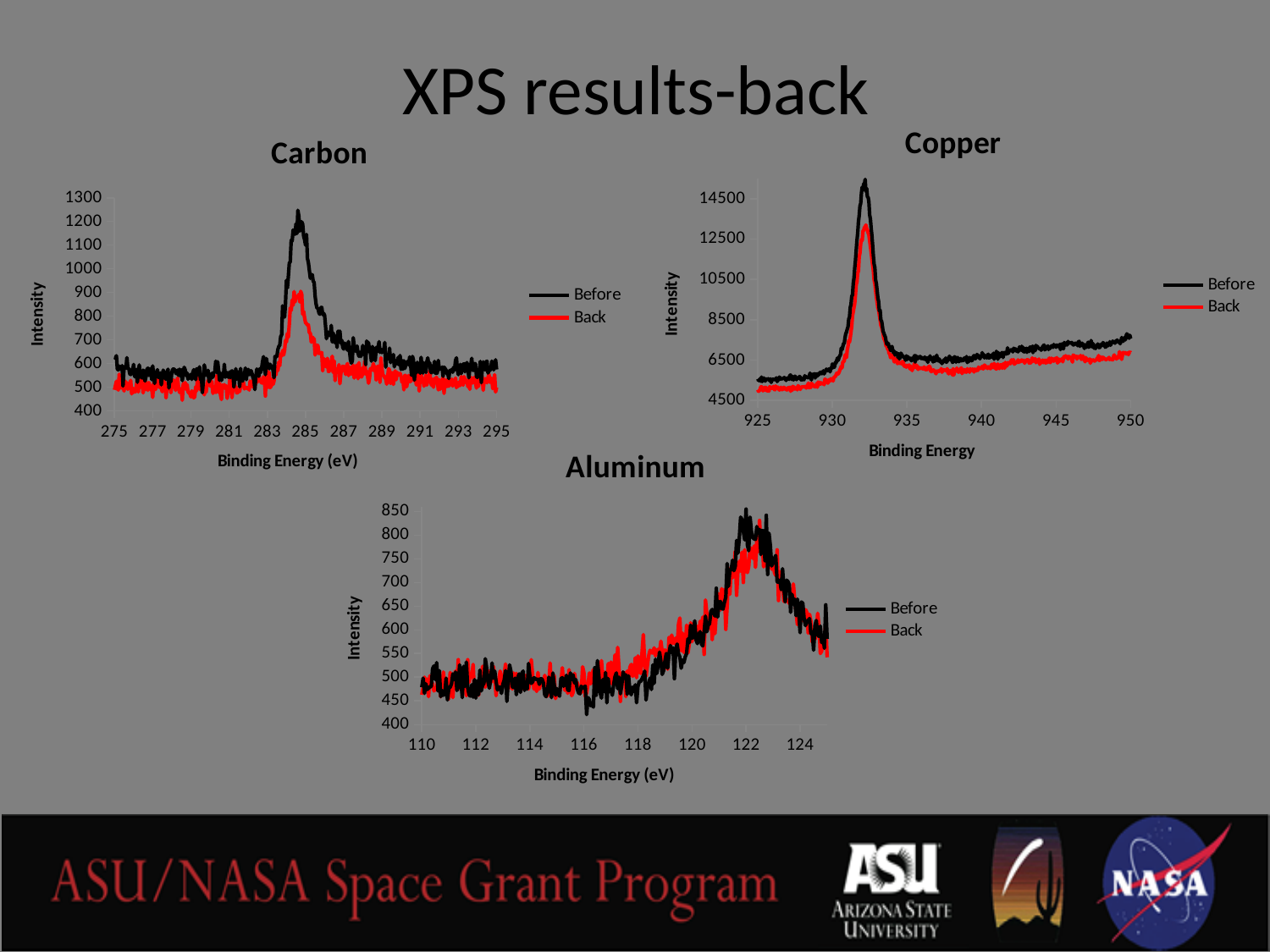
What are the two legend entries in the Aluminum chart? Before and Back In the Carbon chart, which series reaches the higher peak intensity, Before or Back? Before In the Aluminum chart, is the intensity of the Back series at 110 eV greater or less than 550? less How many series does the legend of the Copper chart list? 2 In the Copper chart, which series has the lower peak intensity, Before or Back? Back In the Carbon chart, is the peak intensity of the Before series greater or less than 1100? greater In the Aluminum chart, is the peak intensity of the Before series greater or less than 750? greater What is the x-axis label of the Carbon chart? Binding Energy (eV) What kind of chart is the Carbon chart? line chart